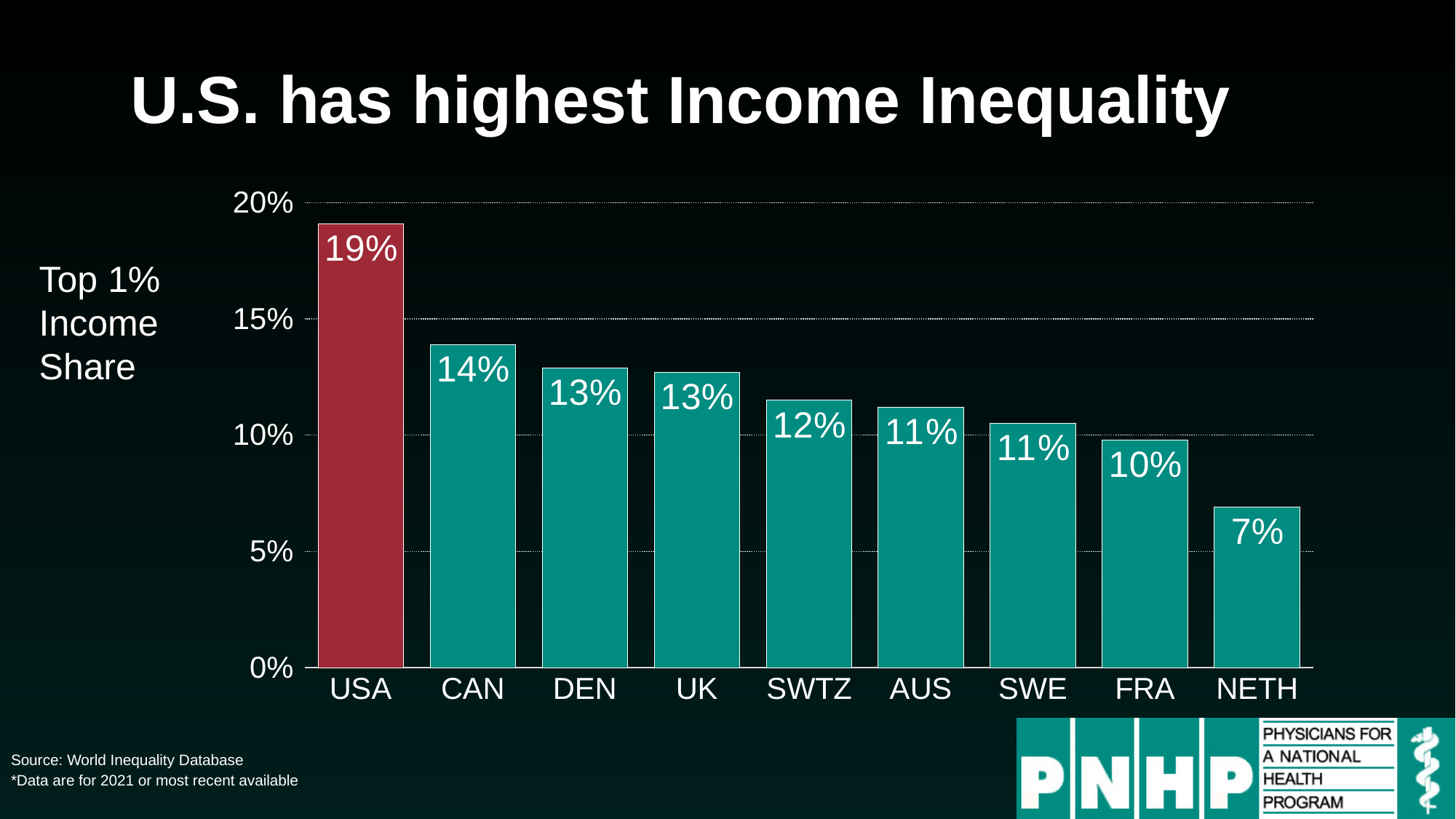
Which country has the highest top 1% income share? USA What is the difference between the USA's and CAN's top 1% income share? 5% Which has a larger top 1% income share, SWTZ or FRA? SWTZ What is the top 1% income share for NETH? 7% How many countries are shown in the chart? 9 Which bar is coloured differently from the others? USA Which country has the lowest top 1% income share? NETH What is the top 1% income share for CAN? 14% What is the top 1% income share for the USA? 19% What is the top 1% income share for FRA? 10% Is the value for USA greater or less than 15%? greater What kind of chart is shown on the slide? Bar chart